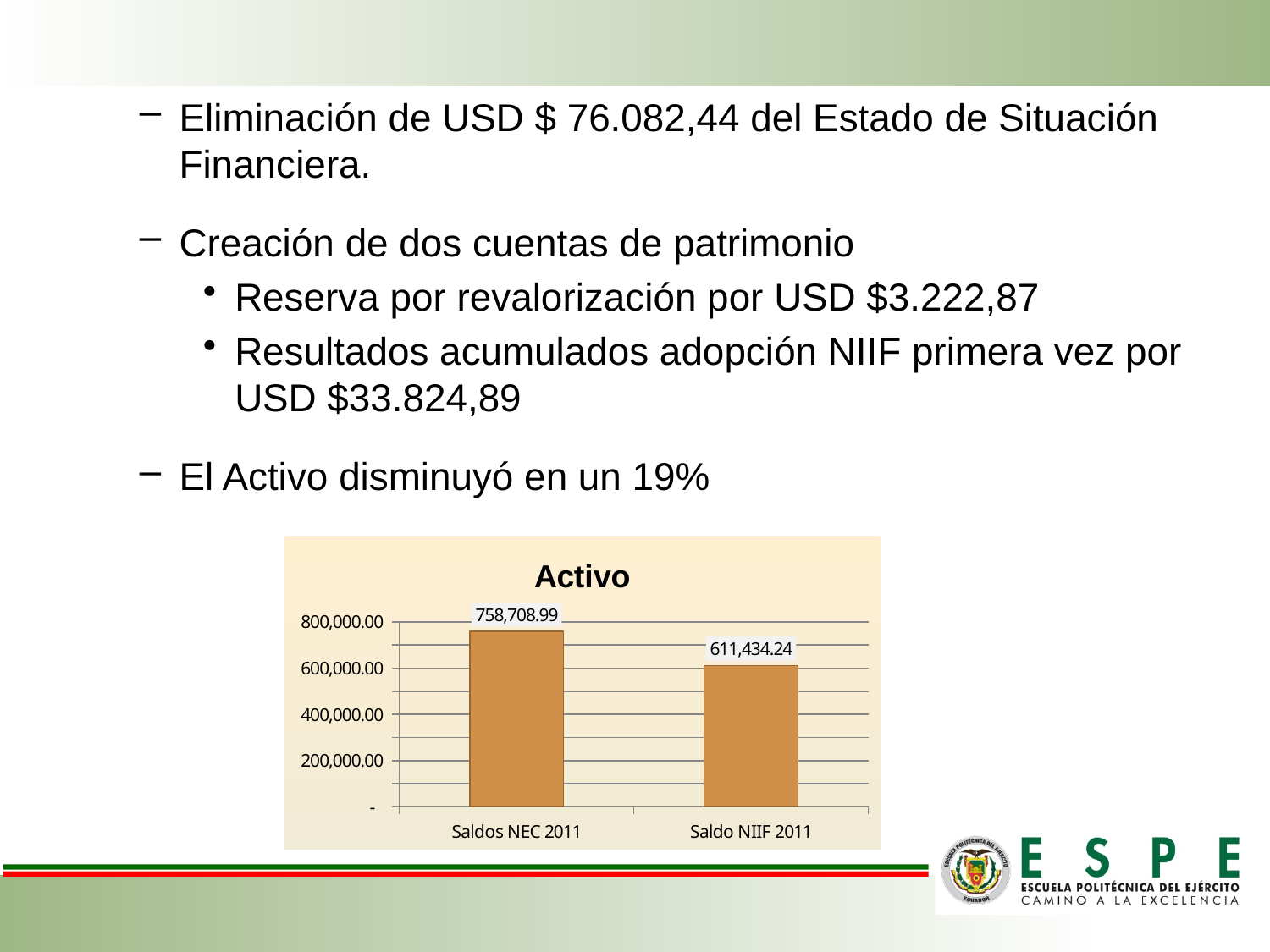
Is the value for Saldos NEC 2011 greater or less than 600,000.00? greater What is the value for Saldos NEC 2011 in the Activo chart? 758,708.99 What is the value for Saldo NIIF 2011 in the Activo chart? 611,434.24 Which category has the lowest value in the Activo chart? Saldo NIIF 2011 Do the values rise or fall from Saldos NEC 2011 to Saldo NIIF 2011 in the chart? Fall Which category has the highest value in the Activo chart? Saldos NEC 2011 How many categories are shown in the Activo chart? 2 What kind of chart is shown on the slide? Bar chart What is the title of the chart on the slide? Activo Which is larger in the Activo chart: Saldos NEC 2011 or Saldo NIIF 2011? Saldos NEC 2011 Is the value for Saldo NIIF 2011 greater or less than 800,000.00? less What is the difference between the Saldos NEC 2011 and Saldo NIIF 2011 values in the Activo chart? 147,274.75